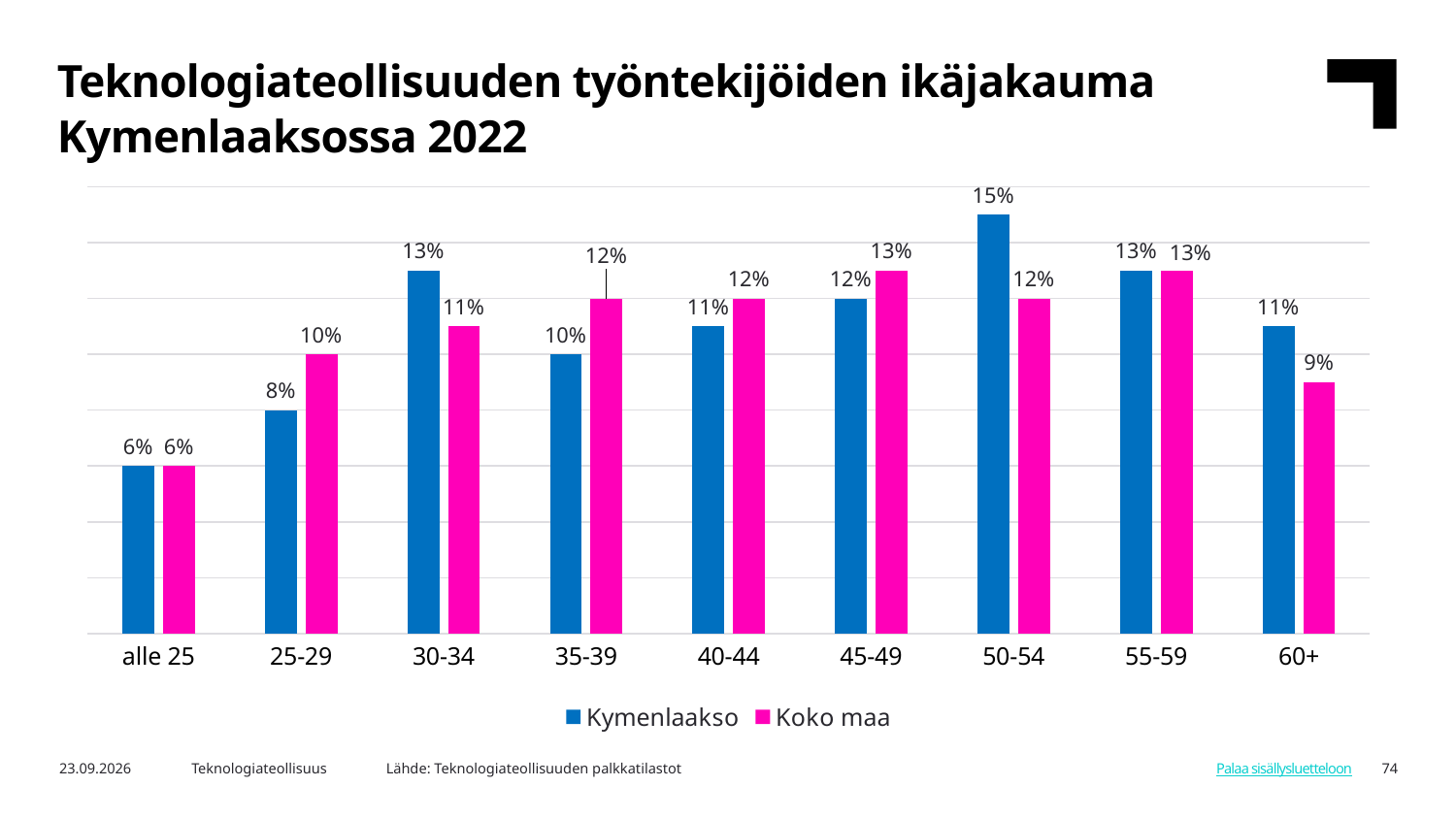
Which age group has the lowest Koko maa value? alle 25 What is the Kymenlaakso value for the 50-54 age group? 15% Which series is shown in pink in the legend? Koko maa Which is larger for the 30-34 age group, the Kymenlaakso value or the Koko maa value? Kymenlaakso Which is larger for the 35-39 age group, the Kymenlaakso value or the Koko maa value? Koko maa What kind of chart is shown on the slide? Bar chart How many age groups are shown on the x axis? 9 What is the Kymenlaakso value for the 60+ age group? 11% Which age group has the highest Kymenlaakso value? 50-54 What is the difference between the Kymenlaakso and Koko maa values for the 50-54 age group? 3% How many series does the legend list? 2 What is the Koko maa value for the 25-29 age group? 10%